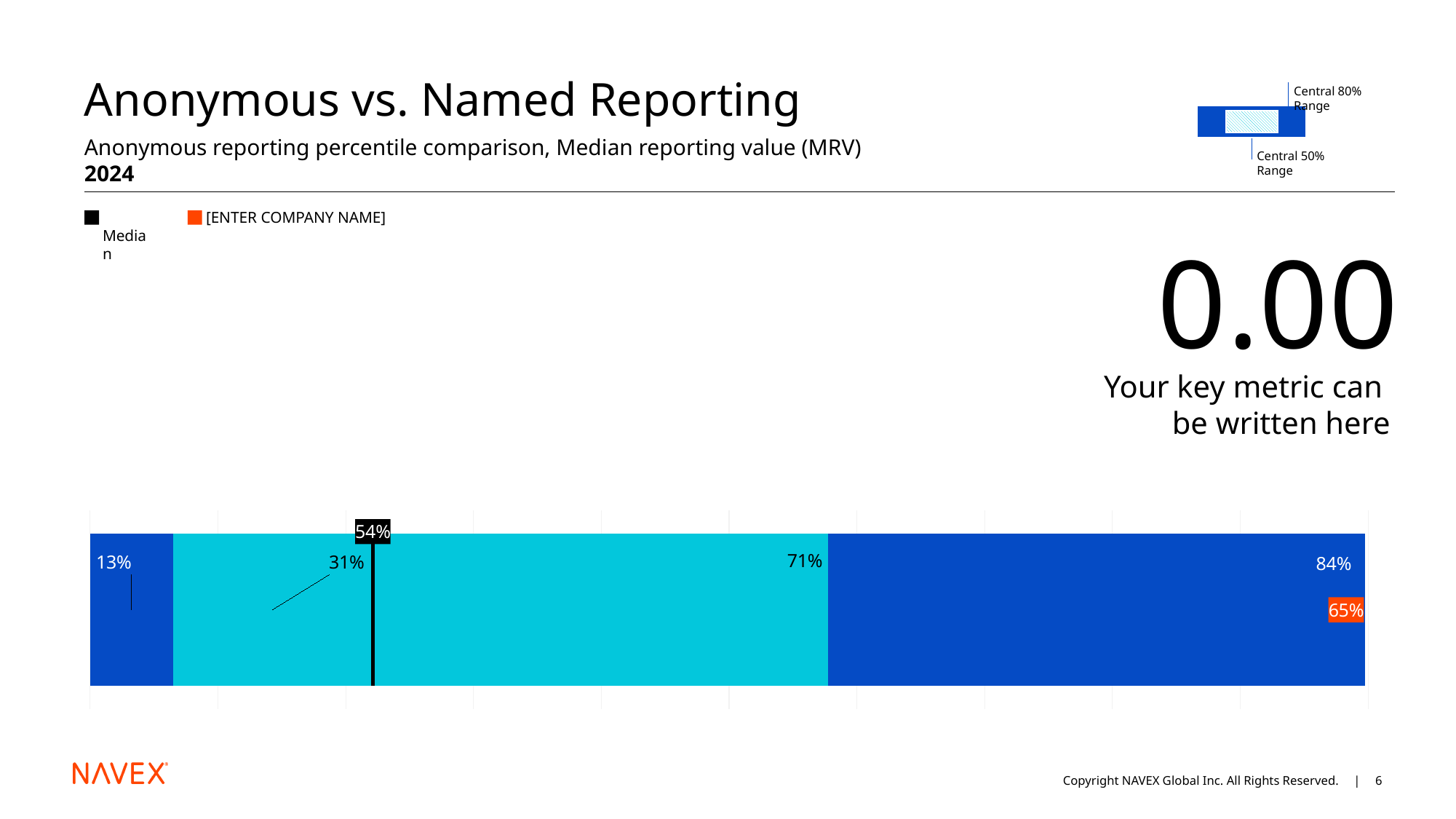
What is the lowest percentile value labelled on the bar? 13% What is the difference between the company value (65%) and the median (54%)? 11% What is the lower bound of the central 50% range on the chart? 31% What is the upper bound of the central 50% range on the chart? 71% How many series does the legend list? 2 What is the highest percentile value labelled on the bar? 84% What is the difference between the upper and lower bounds of the central 50% range (71% and 31%)? 40% What is the median value shown on the chart? 54% What kind of chart is shown on the slide? Bar chart What is the title of the chart on the slide? Anonymous vs. Named Reporting What value is shown for [ENTER COMPANY NAME] on the chart? 65% Which is larger, the company value or the median? The company value (65%)